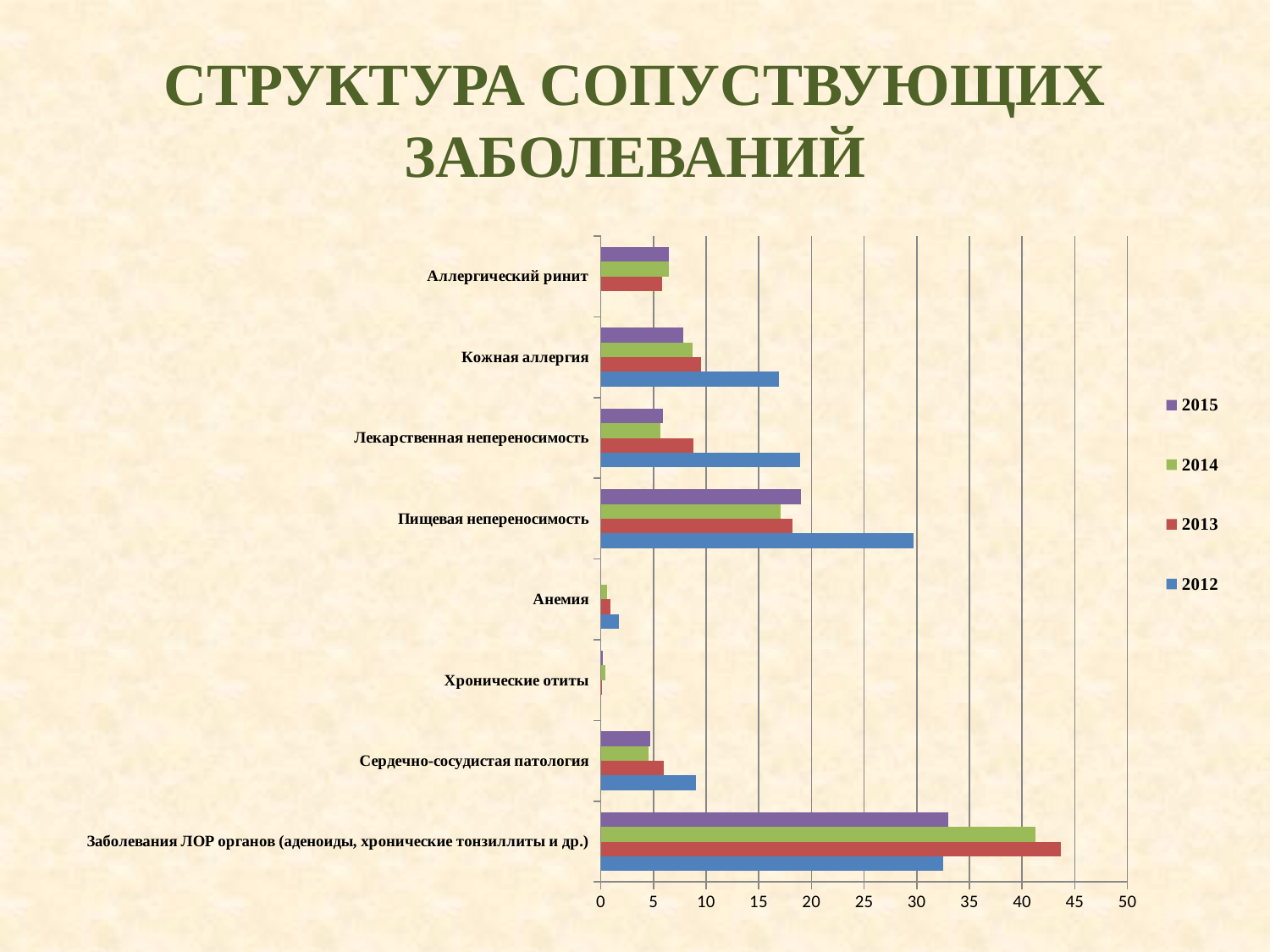
Which category has the highest value for 2013? Заболевания ЛОР органов (аденоиды, хронические тонзиллиты и др.) Is the 2013 value for Заболевания ЛОР органов greater or less than 40? greater Is the 2012 value for Пищевая непереносимость greater or less than 25? greater Which years are listed in the legend? 2015, 2014, 2013, 2012 For Кожная аллергия, which year has the larger value, 2012 or 2015? 2012 How many series does the legend list? 4 What kind of chart is shown on the slide? bar chart Is the 2015 value for Пищевая непереносимость greater or less than 15? greater Which category has the smallest bars across all years? Хронические отиты For Заболевания ЛОР органов, which year has the larger value, 2014 or 2015? 2014 How many disease categories are plotted on the chart? 8